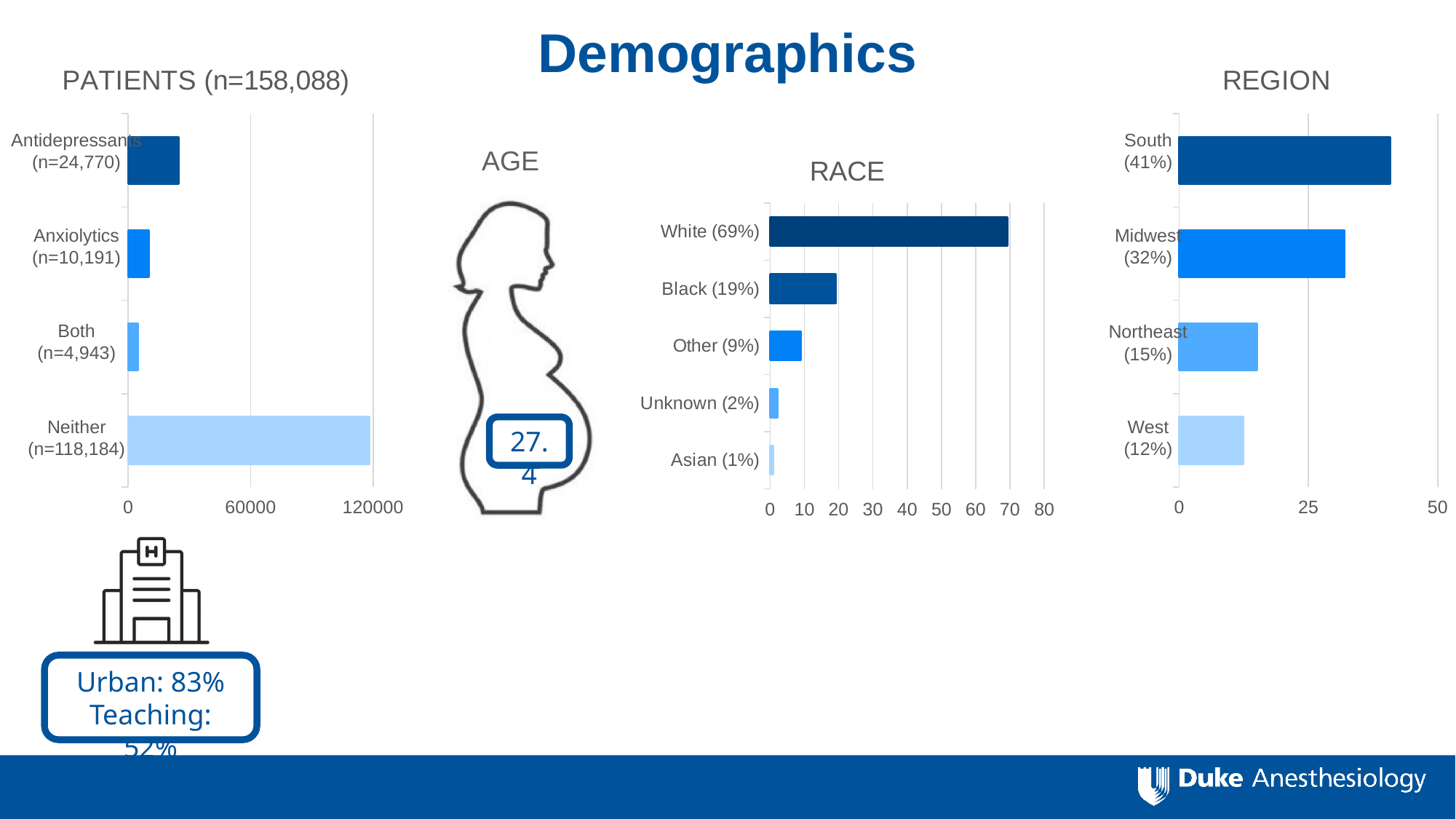
In the RACE chart, is the value for White greater or less than 60? greater How many categories does the PATIENTS chart show? 4 In the PATIENTS chart, what is the difference between the Antidepressants and Anxiolytics counts? 14,579 In the RACE chart, what percentage is shown for Black? 19% How many categories does the RACE chart show? 5 In the PATIENTS chart, how many patients are in the Antidepressants category? 24,770 What kind of chart is the REGION chart? Bar chart In the REGION chart, which region has the highest percentage? South In the RACE chart, which category has the lowest percentage? Asian In the PATIENTS chart, which category has the smallest number of patients? Both In the REGION chart, what percentage is shown for the Midwest? 32% In the PATIENTS chart, which category has the largest number of patients? Neither